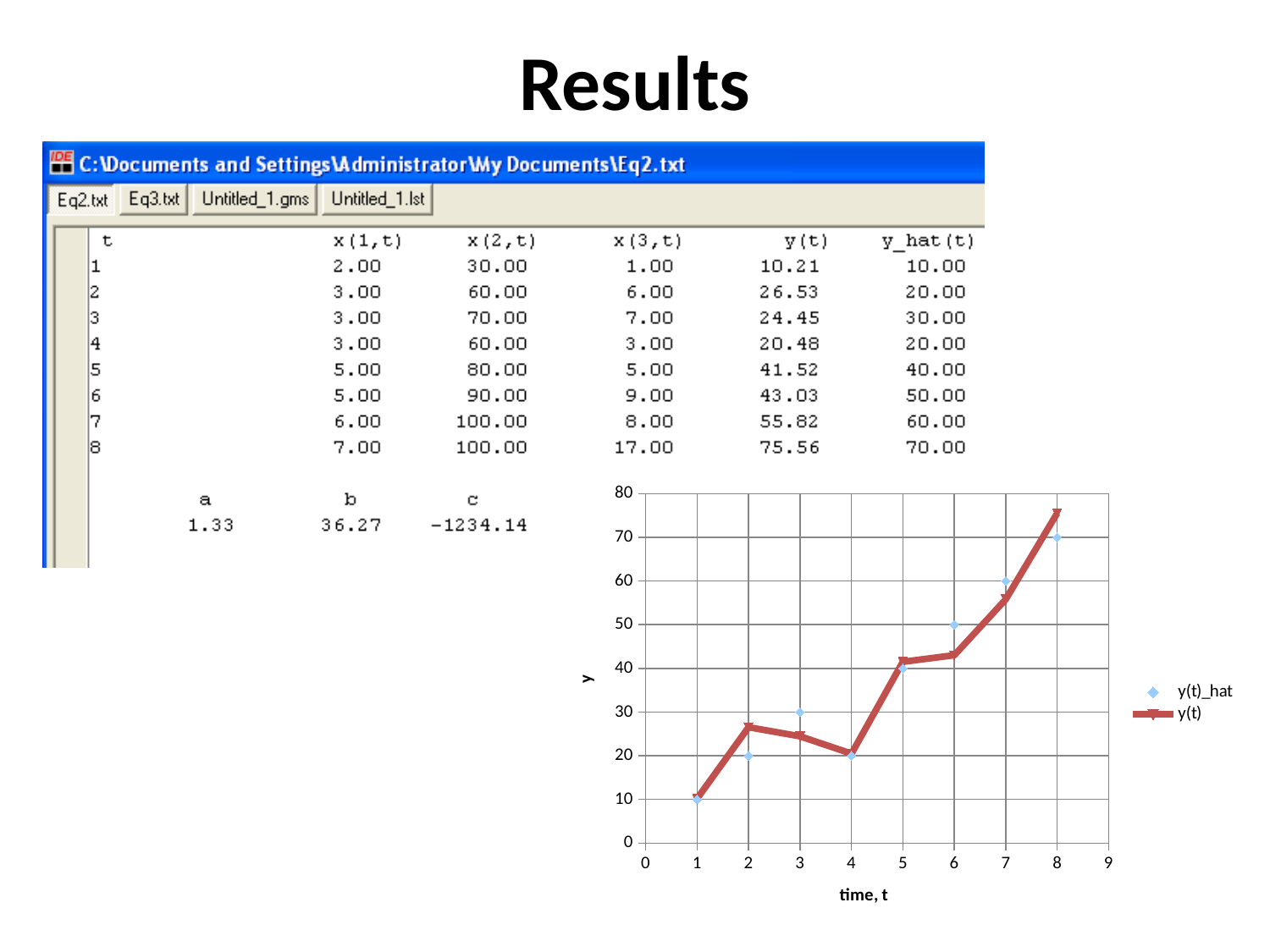
How many data points does the y(t) series have on the chart? 8 Is the value of y(t) at t = 8 greater or less than 70? greater What are the two series named in the chart's legend? y(t)_hat and y(t) What is the title of the chart's x axis? time, t At t = 6, which series has the larger value, y(t) or y(t)_hat? y(t)_hat What is the value of y(t)_hat at t = 5 on the chart? 40 What is the value of y(t)_hat at t = 8 on the chart? 70 Is the value of y(t) at t = 3 greater or less than 30? less How many series does the chart's legend list? 2 What kind of chart is shown on the slide? line chart At which value of t is y(t) highest on the chart? 8 At which value of t is y(t) lowest on the chart? 1